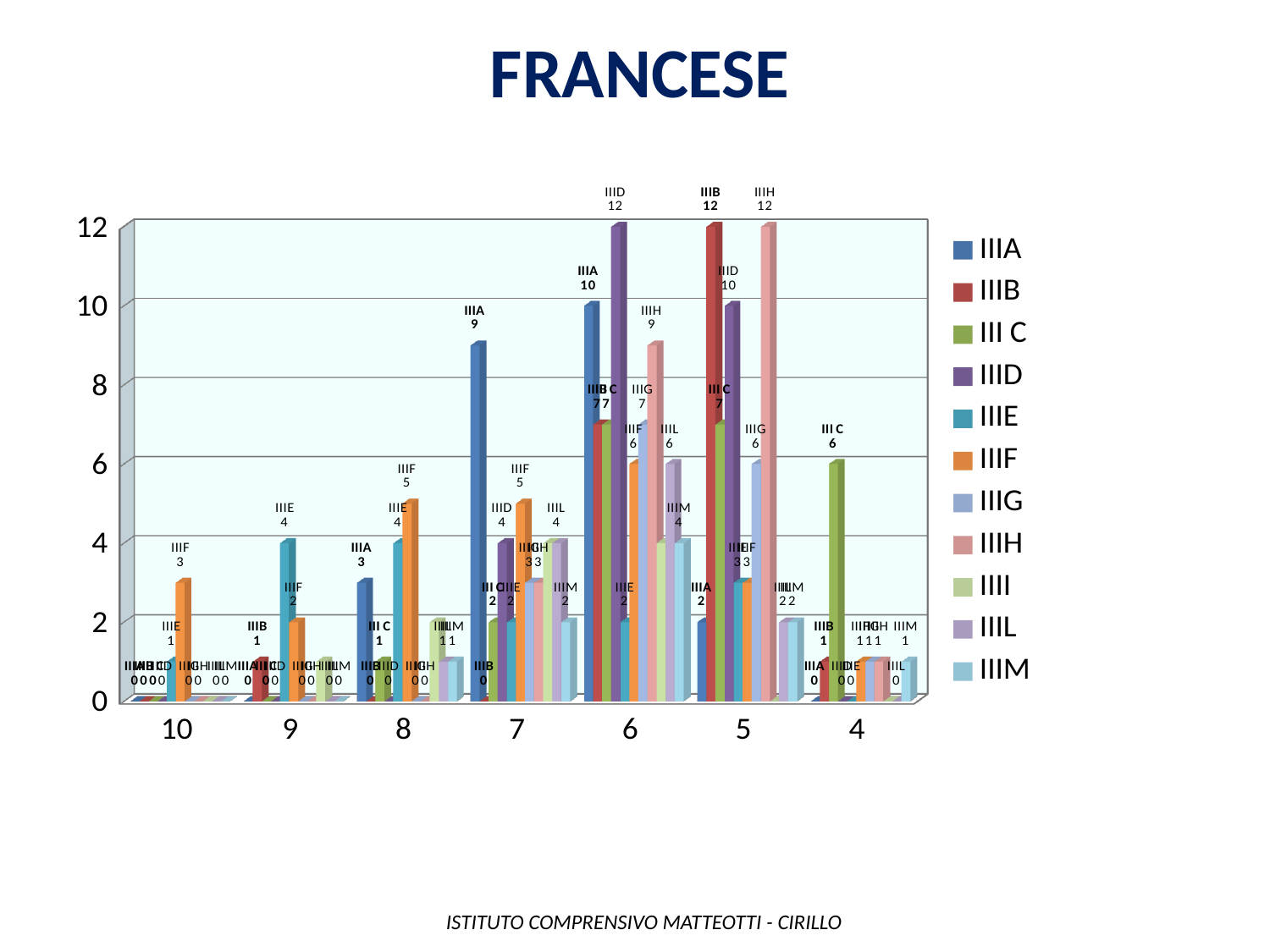
What is the value for III C at grade 4? 6 What is the value for IIID at grade 6? 12 What is the title of the chart? FRANCESE What is the difference between the IIIA value at grade 6 and the IIIA value at grade 5? 8 How many series does the legend list? 11 Which series has the highest value at grade 6? IIID What is the value for IIIF at grade 10? 3 What is the value for IIIH at grade 5? 12 At grade 8, which is larger: the value for IIIF or the value for IIIE? IIIF How many grade categories are shown on the x axis? 7 What is the value for IIIA at grade 7? 9 What kind of chart is shown on the slide? Bar chart